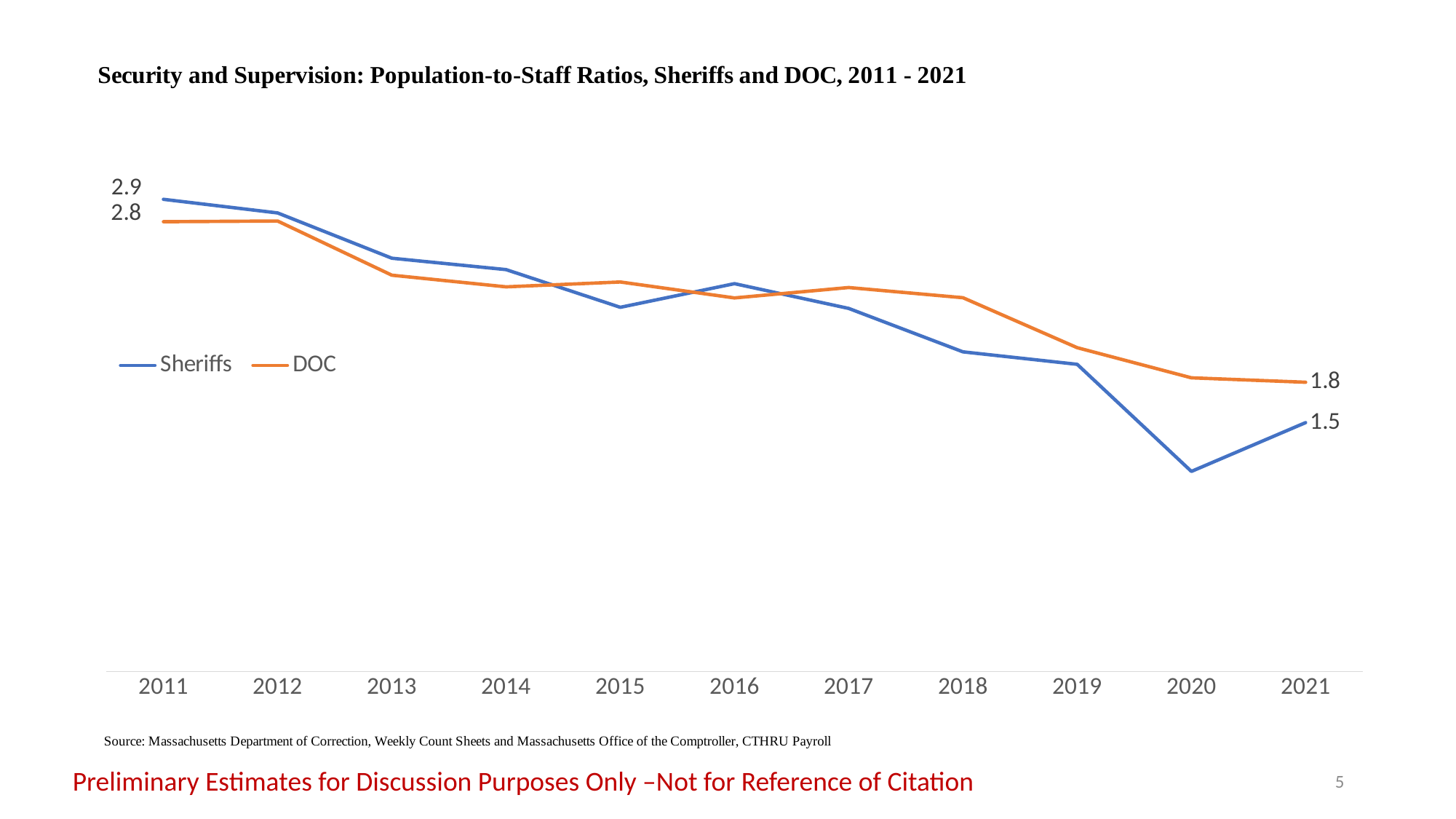
What is the DOC population-to-staff ratio in 2021? 1.8 In 2021, which series has the higher ratio, Sheriffs or DOC? DOC How many years are plotted along the x axis? 11 How many series does the legend list? 2 Does the DOC ratio generally rise or fall from 2011 to 2021? fall What is the Sheriffs population-to-staff ratio in 2011? 2.9 By how much did the Sheriffs ratio fall from 2011 to 2021? 1.4 What is the difference between the DOC and Sheriffs ratios in 2021? 0.3 What is the Sheriffs population-to-staff ratio in 2021? 1.5 What is the DOC population-to-staff ratio in 2011? 2.8 What kind of chart is shown on the slide? line chart In which year does the Sheriffs line reach its lowest point? 2020